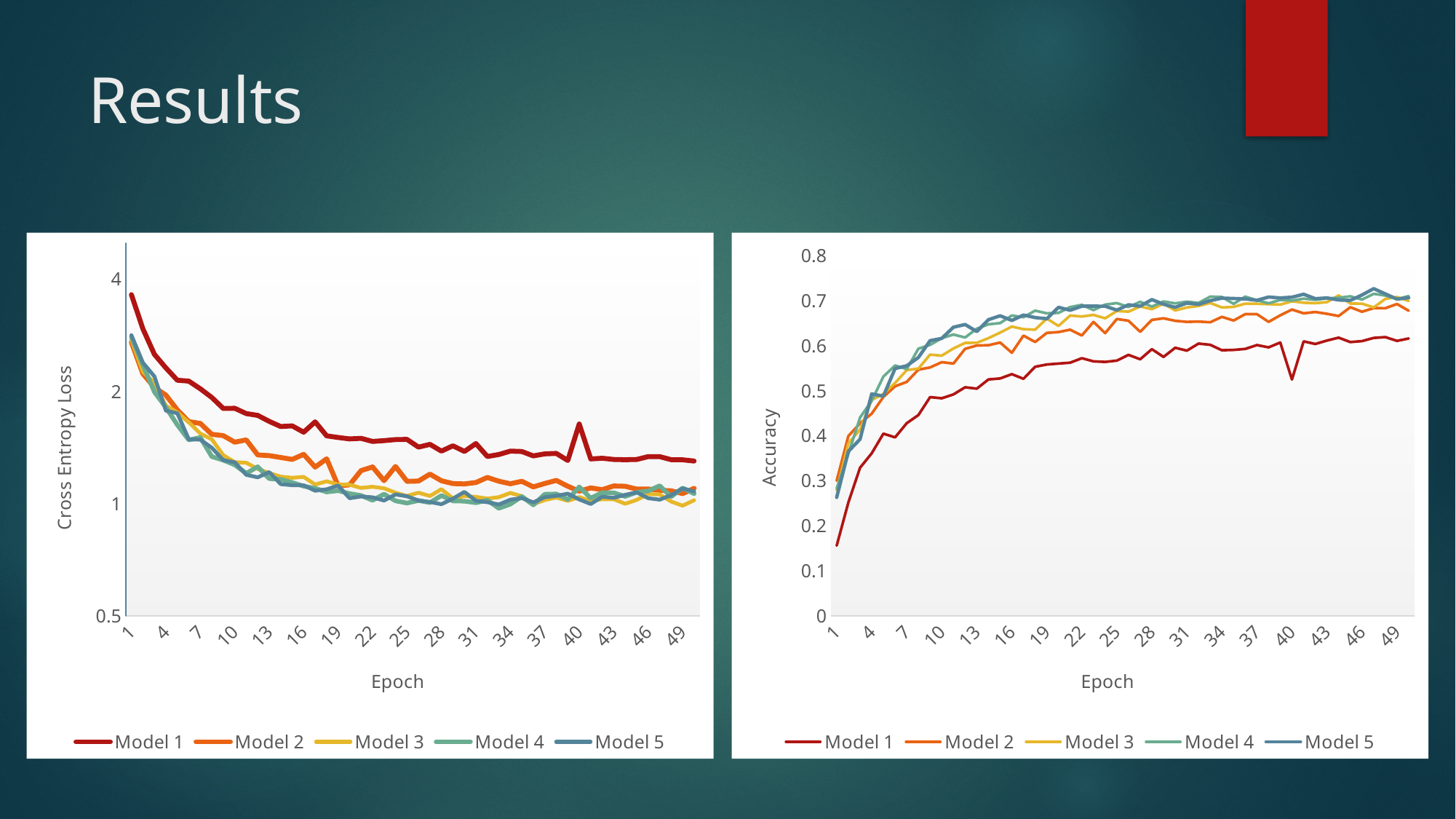
In the right chart (Accuracy), is the value for Model 1 at epoch 49 greater or less than 0.5? greater In the right chart (Accuracy), does the Model 5 line rise or fall as the epoch increases? rise What kind of chart is the right chart (Accuracy)? line chart In the left chart (Cross Entropy Loss), is the value for Model 1 at epoch 1 greater or less than 2? greater What is the label of the x axis on the left chart (Cross Entropy Loss)? Epoch How many series does the legend of the right chart (Accuracy) list? 5 How many series does the legend of the left chart (Cross Entropy Loss) list? 5 In the right chart (Accuracy), which model has the lowest accuracy at epoch 49? Model 1 In the right chart (Accuracy), which is larger at epoch 49: the accuracy of Model 1 or Model 5? Model 5 What kind of chart is the left chart (Cross Entropy Loss)? line chart In the left chart (Cross Entropy Loss), does the Model 1 line rise or fall as the epoch increases? fall In the left chart (Cross Entropy Loss), which model has the highest loss at epoch 49? Model 1